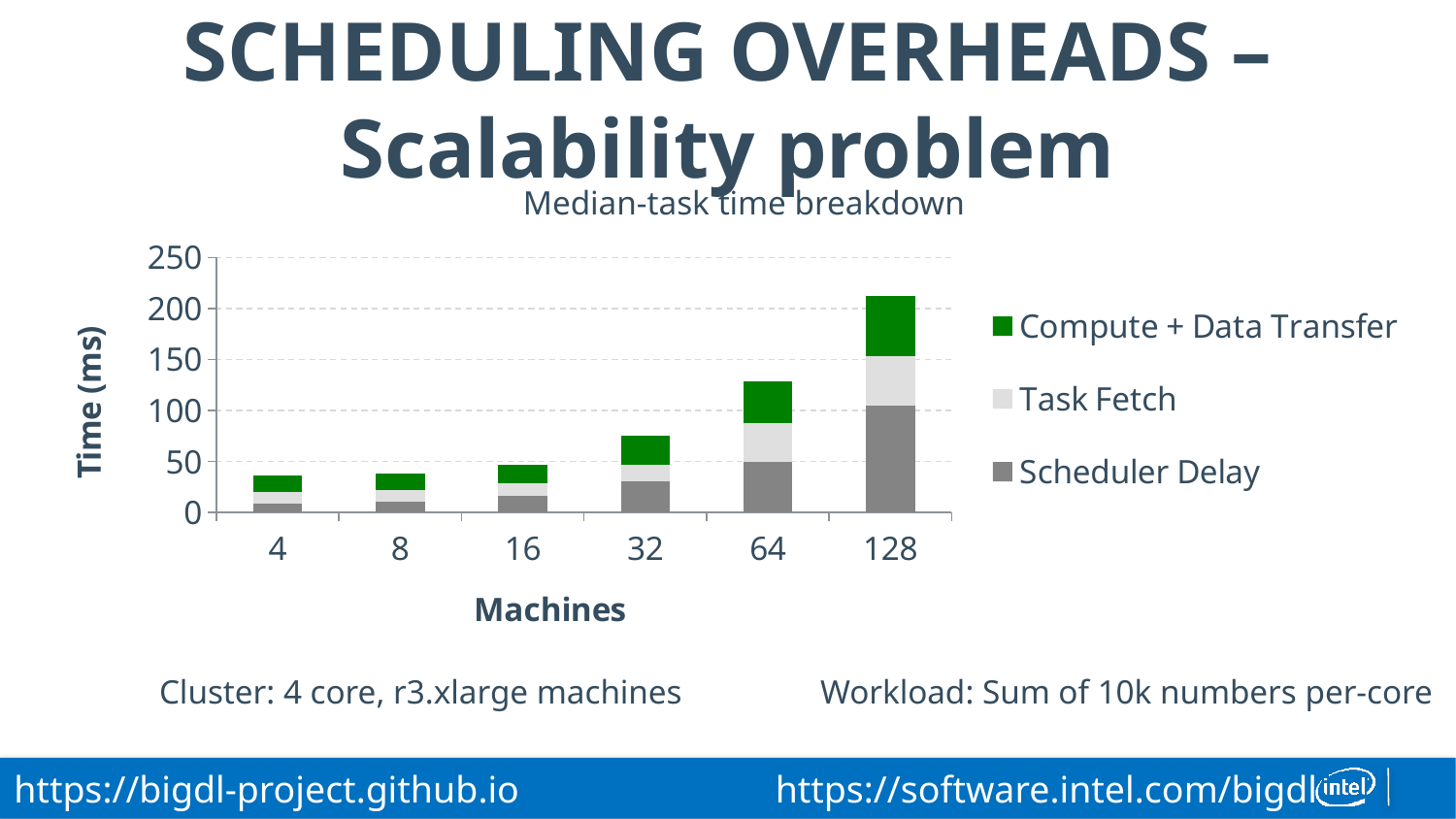
Do the total bar heights rise or fall as the number of machines increases? rise Is the total median-task time for 64 machines greater or less than 100 ms? greater What is the label of the y axis? Time (ms) Which number of machines has the lowest total median-task time? 4 How many machine counts (categories) are shown on the x axis? 6 Which has a larger total median-task time, 64 machines or 128 machines? 128 machines What is the title of the chart? Median-task time breakdown What kind of chart is shown on the slide? stacked bar chart Which number of machines has the highest total median-task time? 128 Is the total median-task time for 128 machines greater or less than 200 ms? greater Is the total median-task time for 4 machines greater or less than 50 ms? less How many series does the legend list? 3